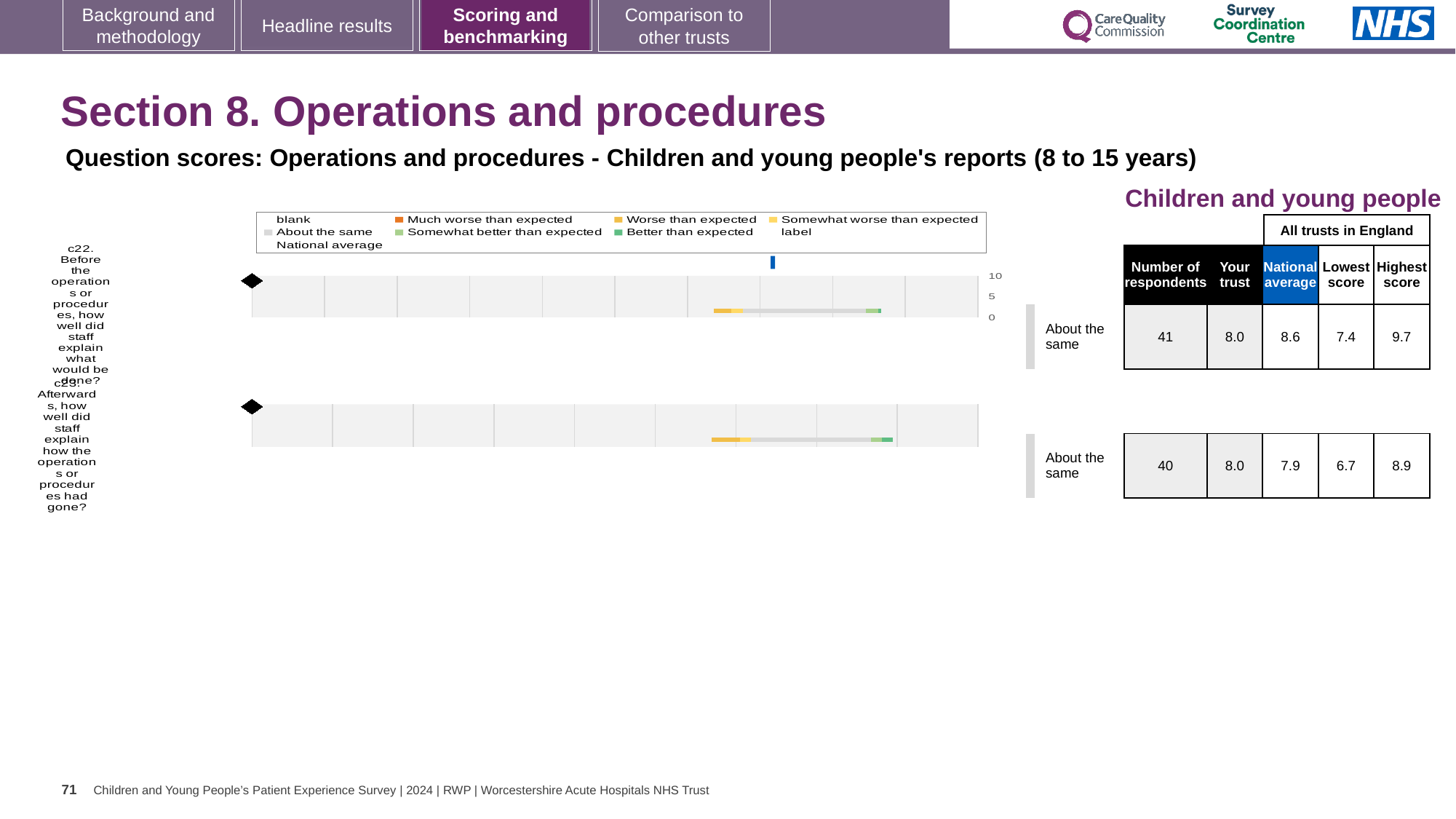
What is the highest score among all trusts in England for question c23? 8.9 What is the difference between the national average for c22 and the national average for c23? 0.7 How many respondents answered question c22? 41 How many entries does the chart legend list? 9 What is the 'Your trust' score for question c22 (Before the operations or procedures, how well did staff explain what would be done?)? 8.0 What benchmark category is shown for question c23? About the same What kind of chart is shown on the slide? Bar chart What is the difference between the highest score and the lowest score for question c22? 2.3 What is the national average score for question c23 (Afterwards, how well did staff explain how the operations or procedures had gone?)? 7.9 For question c23, which is larger: the trust's score or the national average? Your trust How many survey questions are plotted on the chart? 2 For question c22, which is larger: the trust's score or the national average? National average